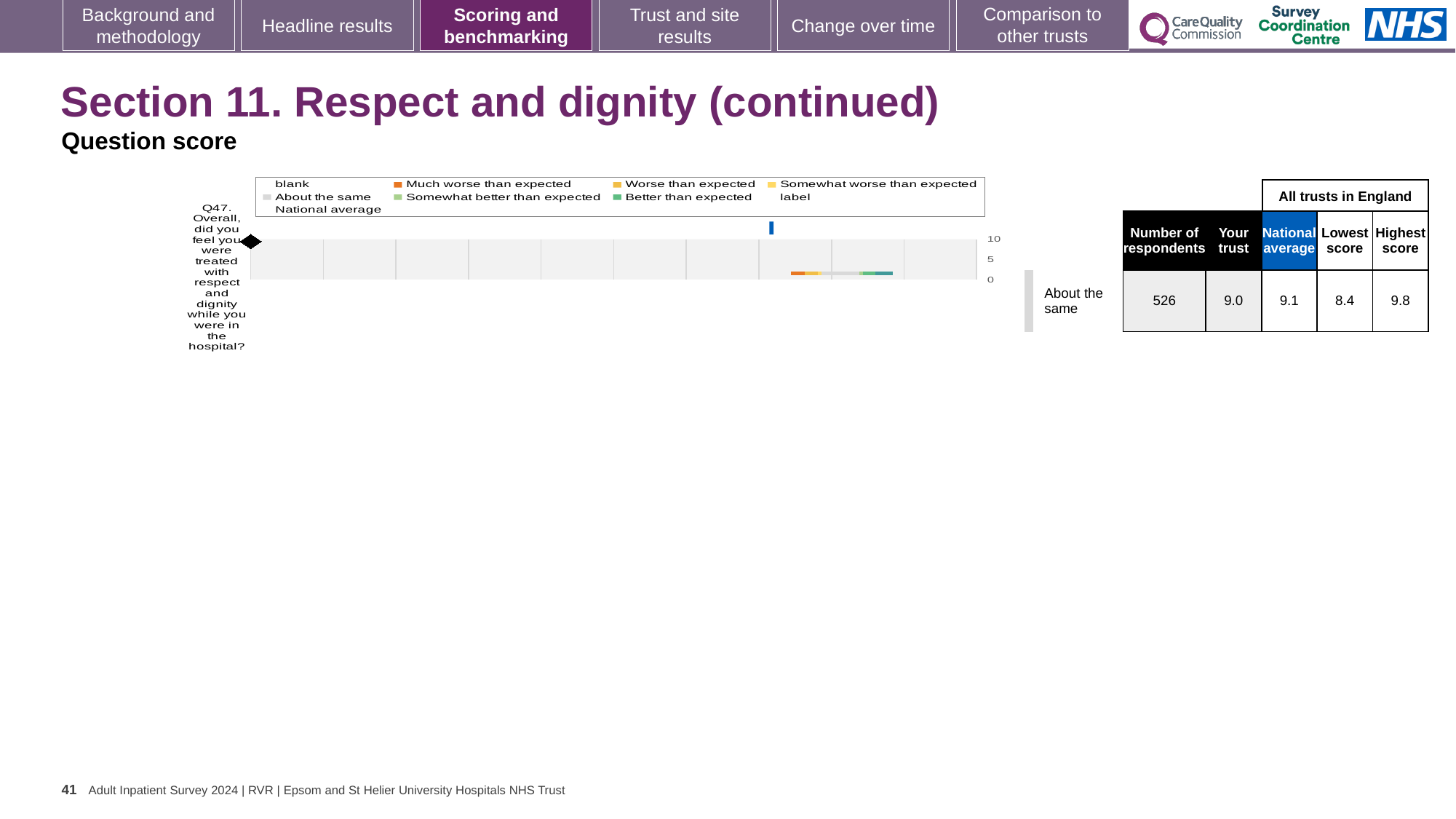
What kind of chart is shown on the slide for Q47? bar chart In the table beside the chart, what is the 'Your trust' score for Q47? 9.0 How many entries does the chart's legend list? 9 In the table beside the chart, what is the Lowest score among all trusts in England for Q47? 8.4 How many questions (categories) are plotted on the chart? 1 In the table beside the chart, what is the Highest score among all trusts in England for Q47? 9.8 For Q47, what is the difference between the Highest score and the Lowest score among all trusts in England? 1.4 Which benchmark category is shown next to the chart for Q47? About the same In the table beside the chart, what is the National average score for Q47? 9.1 For Q47, which is larger: the 'Your trust' score or the National average score? National average What is the highest tick value shown on the chart's axis? 10 In the table beside the chart, how many respondents are recorded for Q47? 526